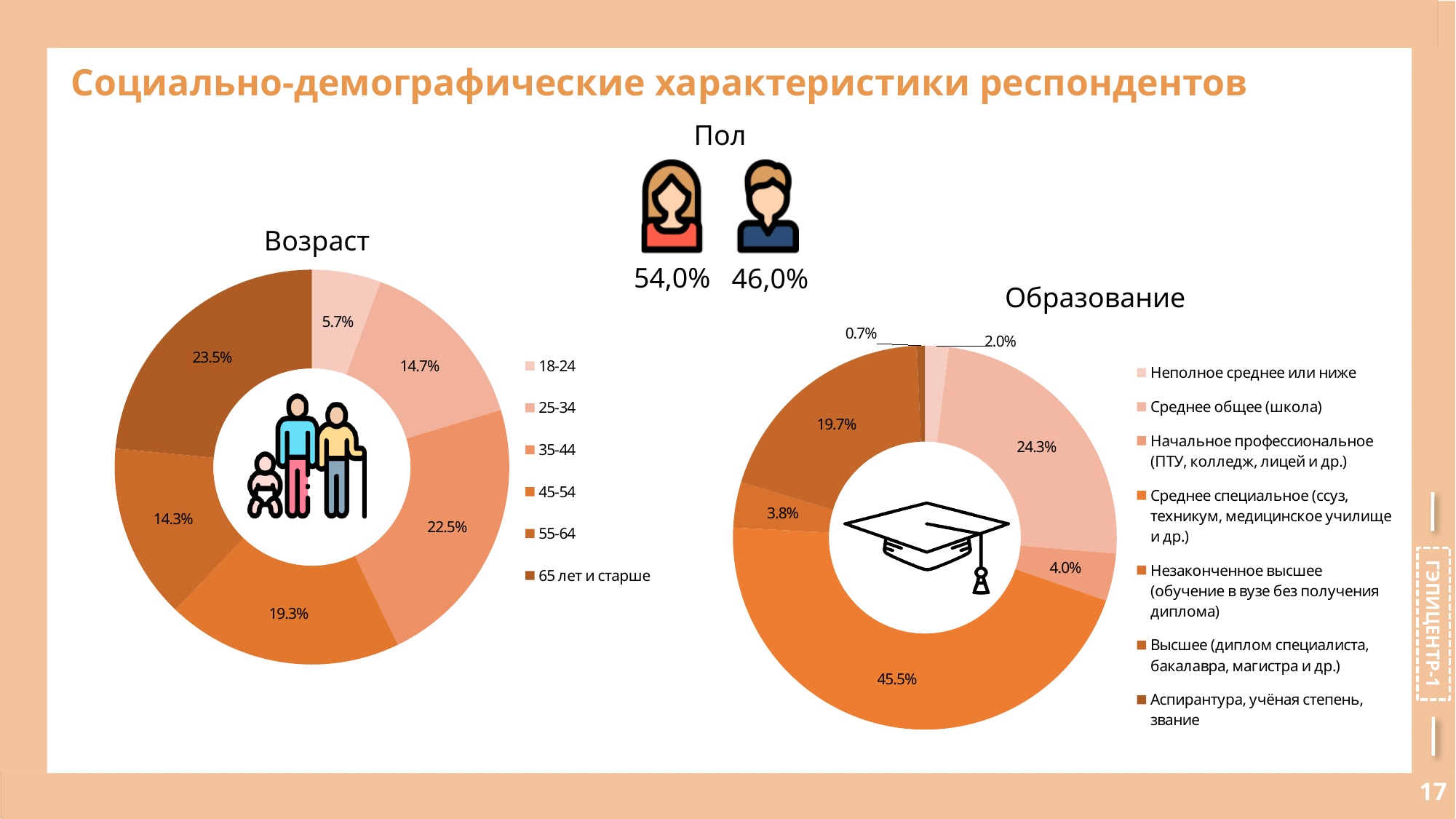
On the "Образование" chart, what share of respondents have "Высшее" education? 19.7% How many age groups are shown on the "Возраст" chart? 6 What type of chart is the "Образование" chart? Donut (pie) chart On the "Образование" chart, what share of respondents have "Среднее специальное" education? 45.5% On the "Возраст" chart, what is the difference between the shares of the 45-54 and 55-64 groups? 5.0% On the "Возраст" chart, which age group has the largest share? 65 лет и старше How many education categories does the legend of the "Образование" chart list? 7 On the "Возраст" chart, what share of respondents are aged 18-24? 5.7% On the "Образование" chart, what is the smallest share shown? 0.7% On the "Возраст" chart, what share of respondents are aged 35-44? 22.5% On the "Возраст" chart, which is larger: the share of 25-34 or the share of 55-64? 25-34 On the "Возраст" chart, which age group has the smallest share? 18-24